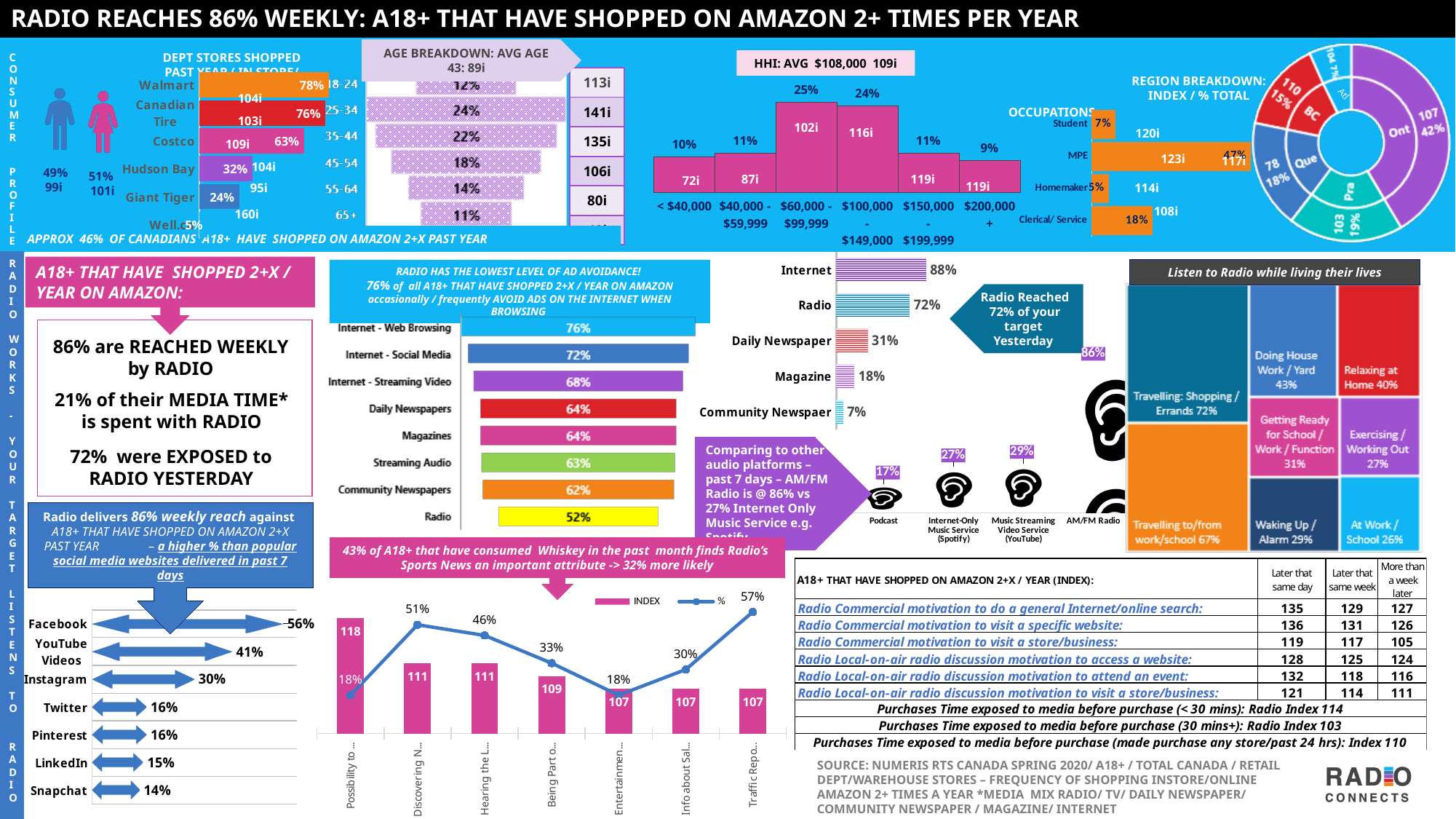
In the Sports News attributes chart at the bottom centre, how many series does the legend list? 2 In the audio platforms chart (past 7 days), what percentage is shown for Podcast? 17% In the 'reached yesterday' chart (Internet, Radio, Daily Newspaper, Magazine, Community Newspaper), what value is shown for Daily Newspaper? 31% In the social media weekly reach chart at the bottom left, which platform has the highest value? Facebook In the social media weekly reach chart, which is larger: YouTube Videos or Instagram? YouTube Videos In the ad avoidance chart, what is the difference between Internet - Web Browsing and Radio? 24% In the HHI (household income) chart, what percentage is shown for the $60,000 - $99,999 bracket? 25% In the ad avoidance chart, how many media categories are plotted? 8 In the 'Dept stores shopped past year' chart, which store has the lowest percentage? Well.ca In the HHI chart, what is the index shown for the < $40,000 bracket? 72i In the ad avoidance chart (Internet - Web Browsing through Radio), which medium has the lowest value? Radio In the 'Dept stores shopped past year' chart, what percentage is shown for Walmart? 78%